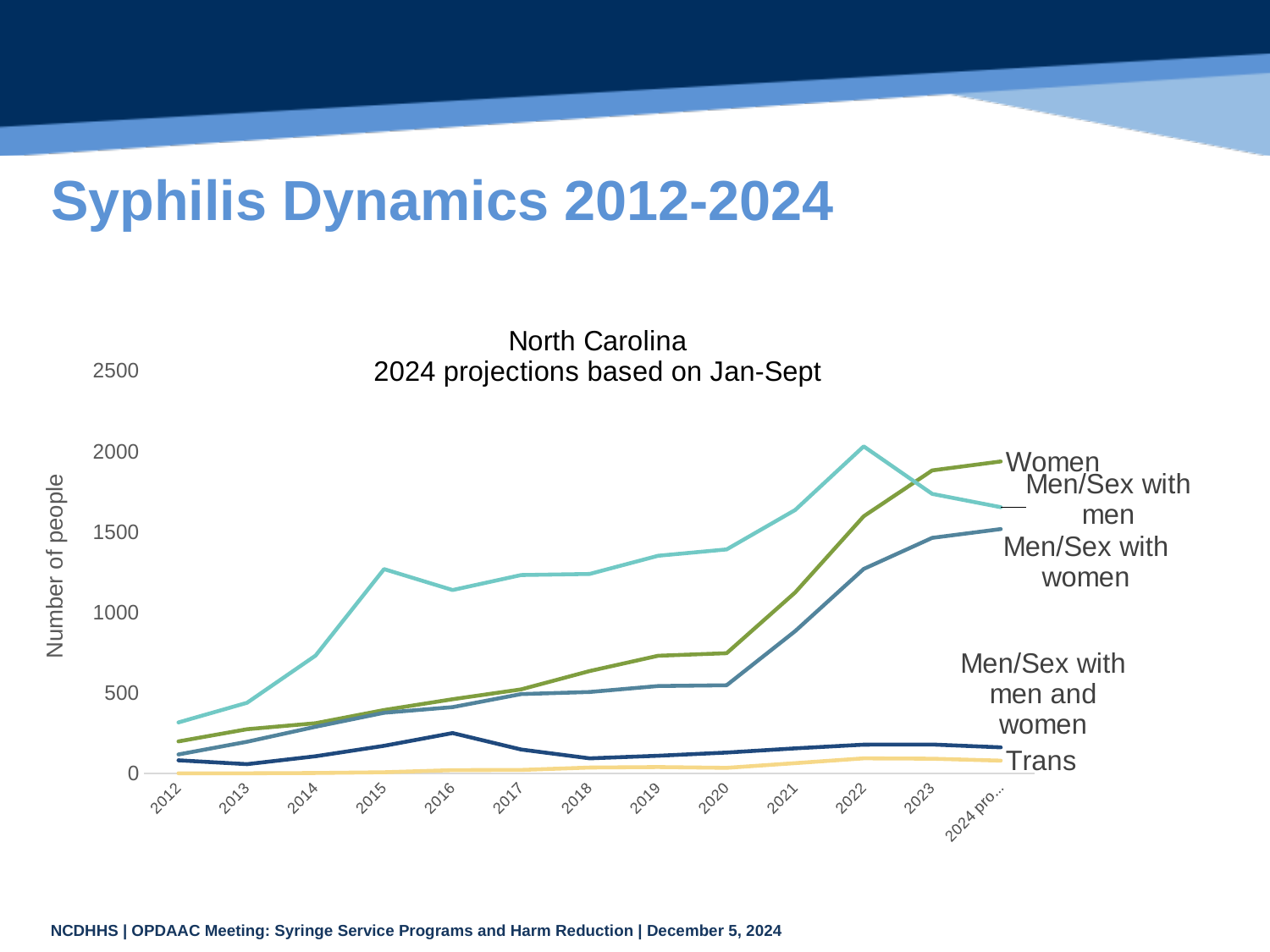
Which series has the lowest value across the chart? Trans What is the label on the y axis of the chart? Number of people In 2022, which is larger: Men/Sex with men or Women? Men/Sex with men Which series has the highest value in 2015? Men/Sex with men Which series has the highest value in the 2024 projection? Women In the 2024 projection, which is larger: Women or Men/Sex with men? Women How many years (points) are shown along the x axis? 13 Does the Women series generally rise or fall from 2012 to the 2024 projection? Rise Is the value for Men/Sex with men in 2015 greater or less than 1000? greater What kind of chart is shown on the slide? Line chart Is the value for Women in 2023 greater or less than 1500? greater How many series are plotted in the chart? 5